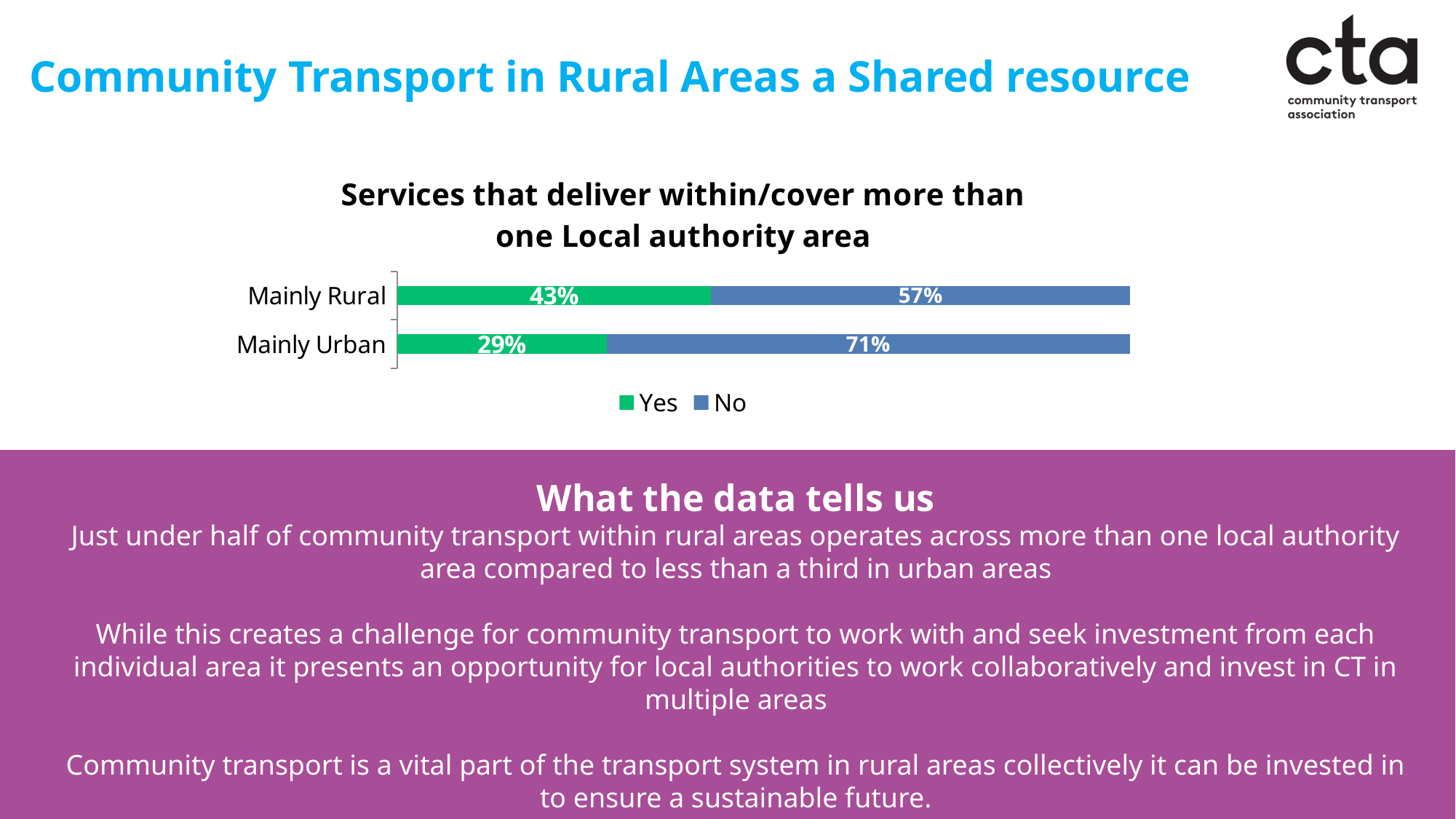
What percentage of Mainly Rural services answered No? 57% How many series does the legend list? 2 What is the difference between the Yes percentages for Mainly Rural and Mainly Urban? 14% What is the title of the chart? Services that deliver within/cover more than one Local authority area What type of chart is shown on the slide? Stacked bar chart What percentage of Mainly Urban services answered Yes? 29% What percentage of Mainly Urban services answered No? 71% Is the No percentage larger for Mainly Rural or Mainly Urban? Mainly Urban Which category has the lower Yes percentage? Mainly Urban Which category has the higher Yes percentage? Mainly Rural How many categories are shown in the chart? 2 What percentage of Mainly Rural services answered Yes? 43%